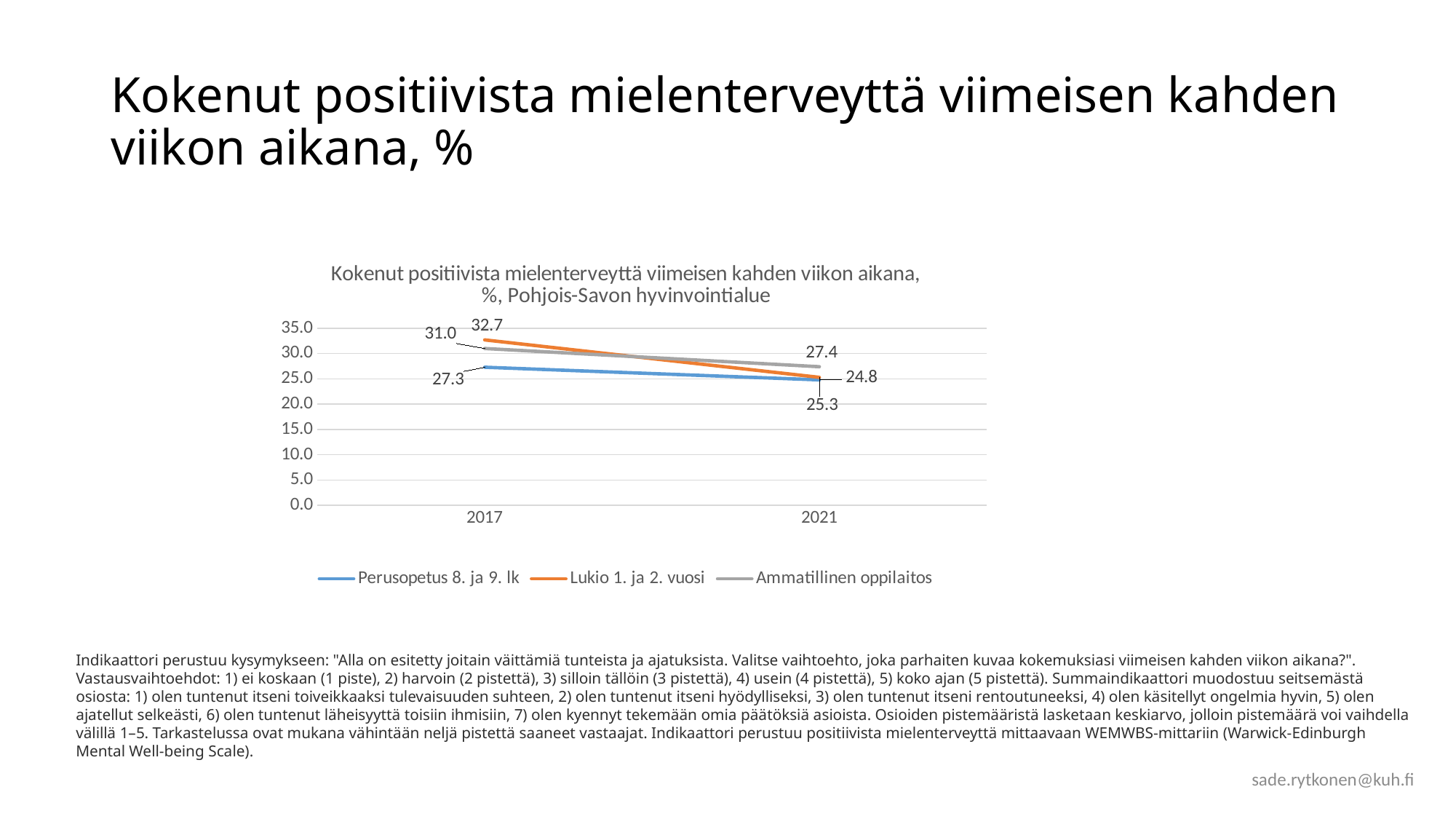
What kind of chart is shown on the slide? line chart How many years are shown on the x axis? 2 What is the value for Ammatillinen oppilaitos in 2021? 27.4 Does the value for Ammatillinen oppilaitos rise or fall from 2017 to 2021? fall Which series has the highest value in 2017? Lukio 1. ja 2. vuosi What is the value for Perusopetus 8. ja 9. lk in 2017? 27.3 Which series has the lowest value in 2021? Perusopetus 8. ja 9. lk What is the value for Lukio 1. ja 2. vuosi in 2017? 32.7 What is the value for Perusopetus 8. ja 9. lk in 2021? 24.8 By how much did the value for Lukio 1. ja 2. vuosi change from 2017 to 2021? 7.4 What is the difference between Ammatillinen oppilaitos and Perusopetus 8. ja 9. lk in 2021? 2.6 How many series does the legend list? 3